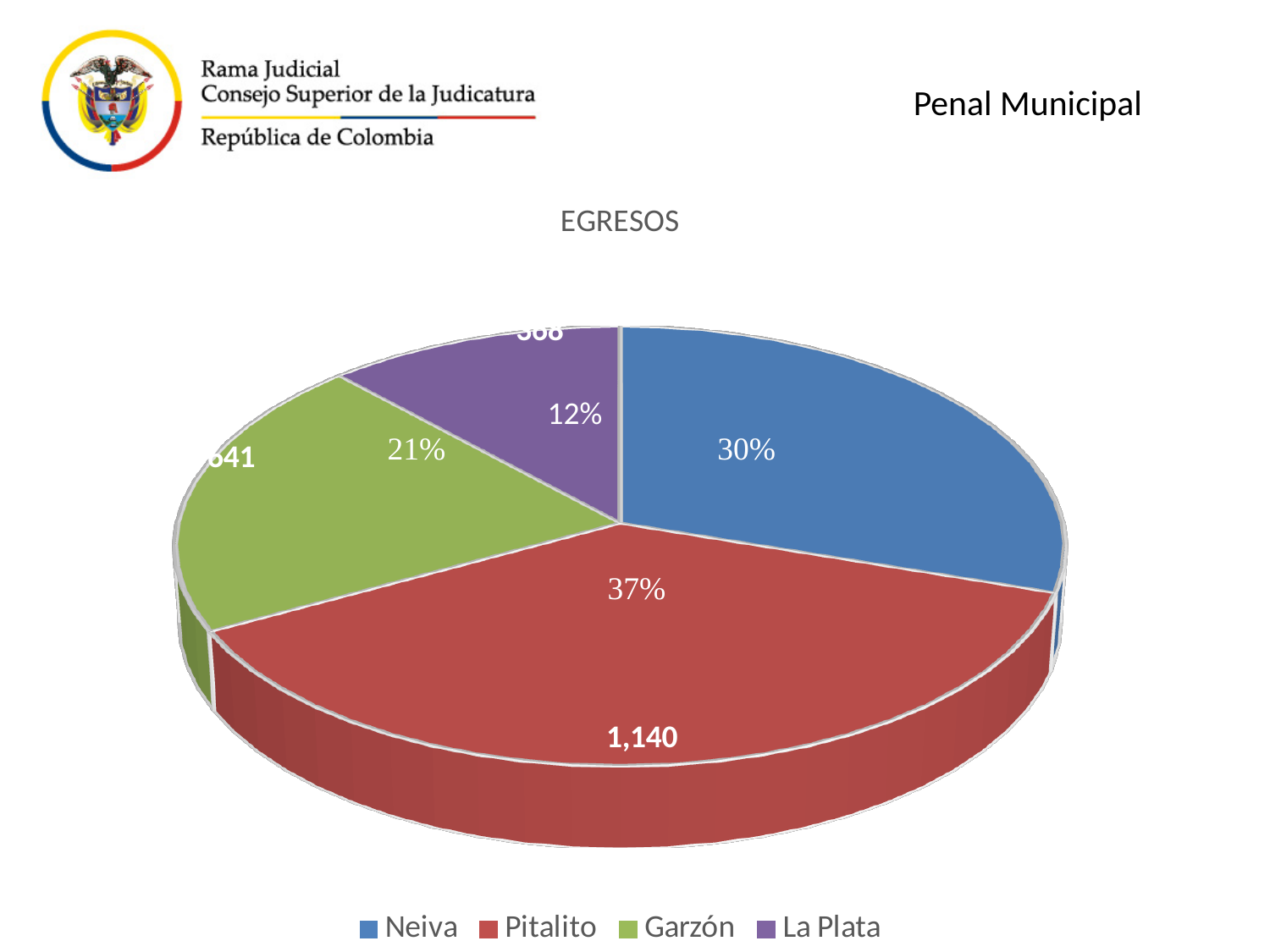
What share of the pie does Garzón represent? 21% Which category has the largest slice of the pie? Pitalito What share of the pie does Neiva represent? 30% Which colour represents Pitalito in the chart? red Which category has the smallest slice of the pie? La Plata What is the value printed for Pitalito? 1,140 What share of the pie does La Plata represent? 12% What kind of chart is shown on the slide? pie chart How many categories does the legend of the chart list? 4 What is the title of the chart? EGRESOS Which has a larger share of the pie, Neiva or Garzón? Neiva